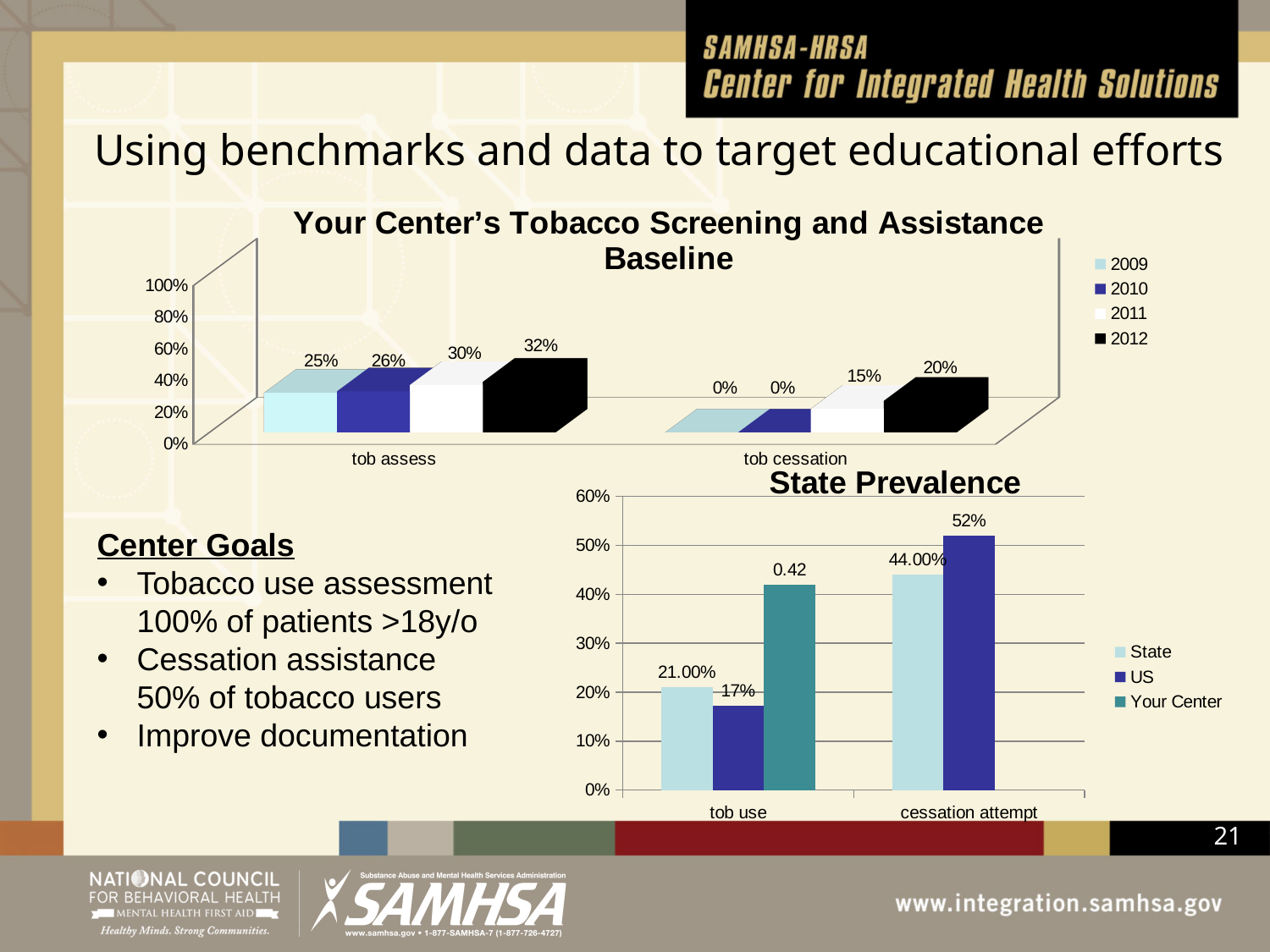
In the 'Your Center's Tobacco Screening and Assistance Baseline' chart, what is the difference between the 2012 and 2009 values for tob assess? 7% In the 'State Prevalence' chart, what is the State value for tob use? 21.00% In the 'State Prevalence' chart, what is the US value for cessation attempt? 52% In the 'Your Center's Tobacco Screening and Assistance Baseline' chart, how many series does the legend list? 4 In the 'Your Center's Tobacco Screening and Assistance Baseline' chart, do the tob assess values rise or fall from 2009 to 2012? rise In the 'State Prevalence' chart, which is larger for cessation attempt, State or US? US What kind of chart is the 'State Prevalence' chart? bar chart In the 'Your Center's Tobacco Screening and Assistance Baseline' chart, which year has the highest value for tob cessation? 2012 In the 'Your Center's Tobacco Screening and Assistance Baseline' chart, what is the value for tob cessation in 2009? 0% In the 'Your Center's Tobacco Screening and Assistance Baseline' chart, what is the value for tob cessation in 2011? 15% In the 'State Prevalence' chart, what is the value for Your Center for tob use? 0.42 In the 'Your Center's Tobacco Screening and Assistance Baseline' chart, what is the value for tob assess in 2012? 32%